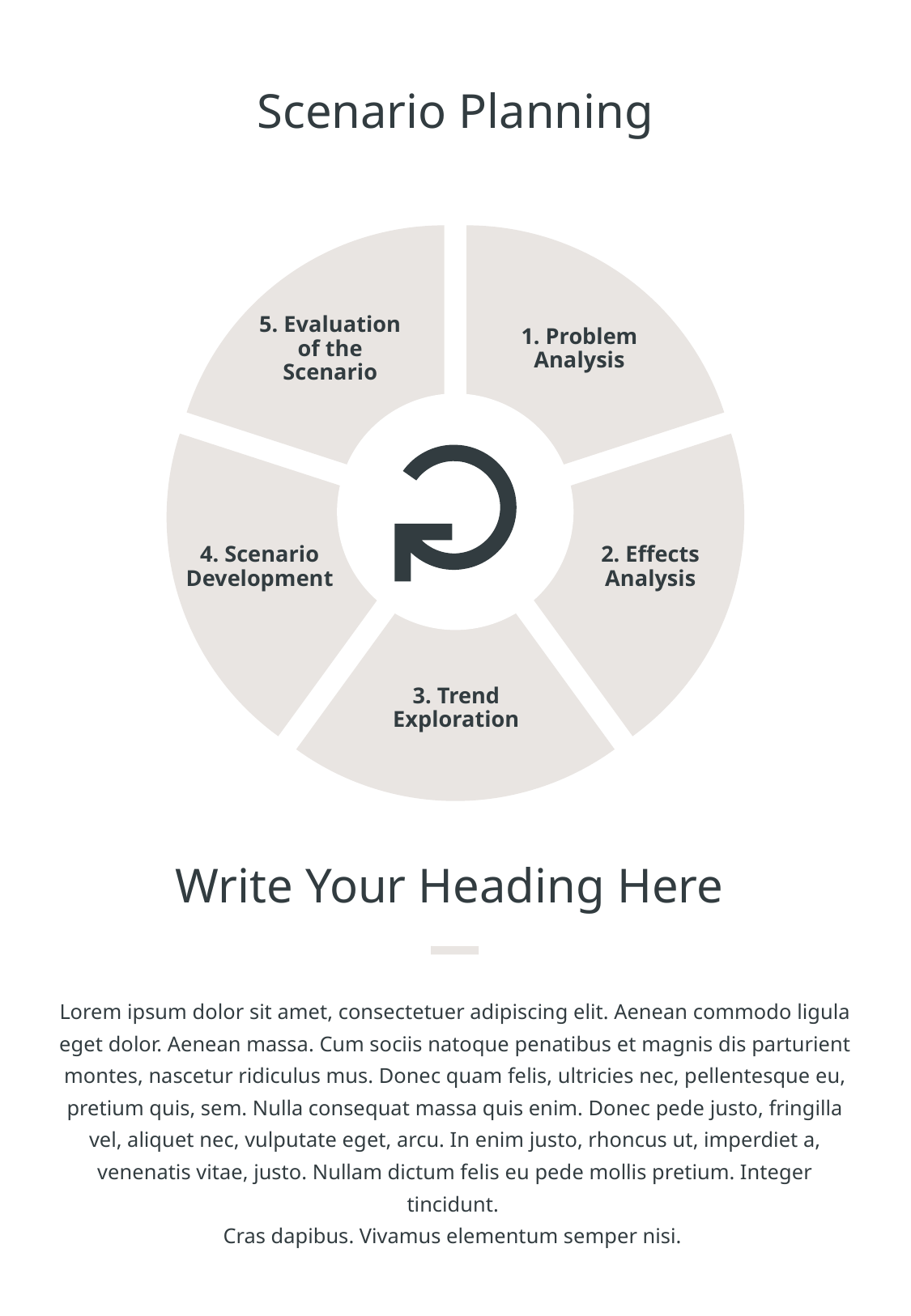
What is the label of the fifth segment in the circular diagram? 5. Evaluation of the Scenario What is the label of the first segment in the circular diagram? 1. Problem Analysis What is the label of the third segment in the circular diagram? 3. Trend Exploration Which step number is assigned to Scenario Development in the diagram? 4 What symbol is shown in the centre of the circular diagram? A circular arrow What is the label of the fourth segment in the circular diagram? 4. Scenario Development What is the label of the second segment in the circular diagram? 2. Effects Analysis What is the title shown above the circular diagram? Scenario Planning How many segments does the circular diagram on the slide contain? 5